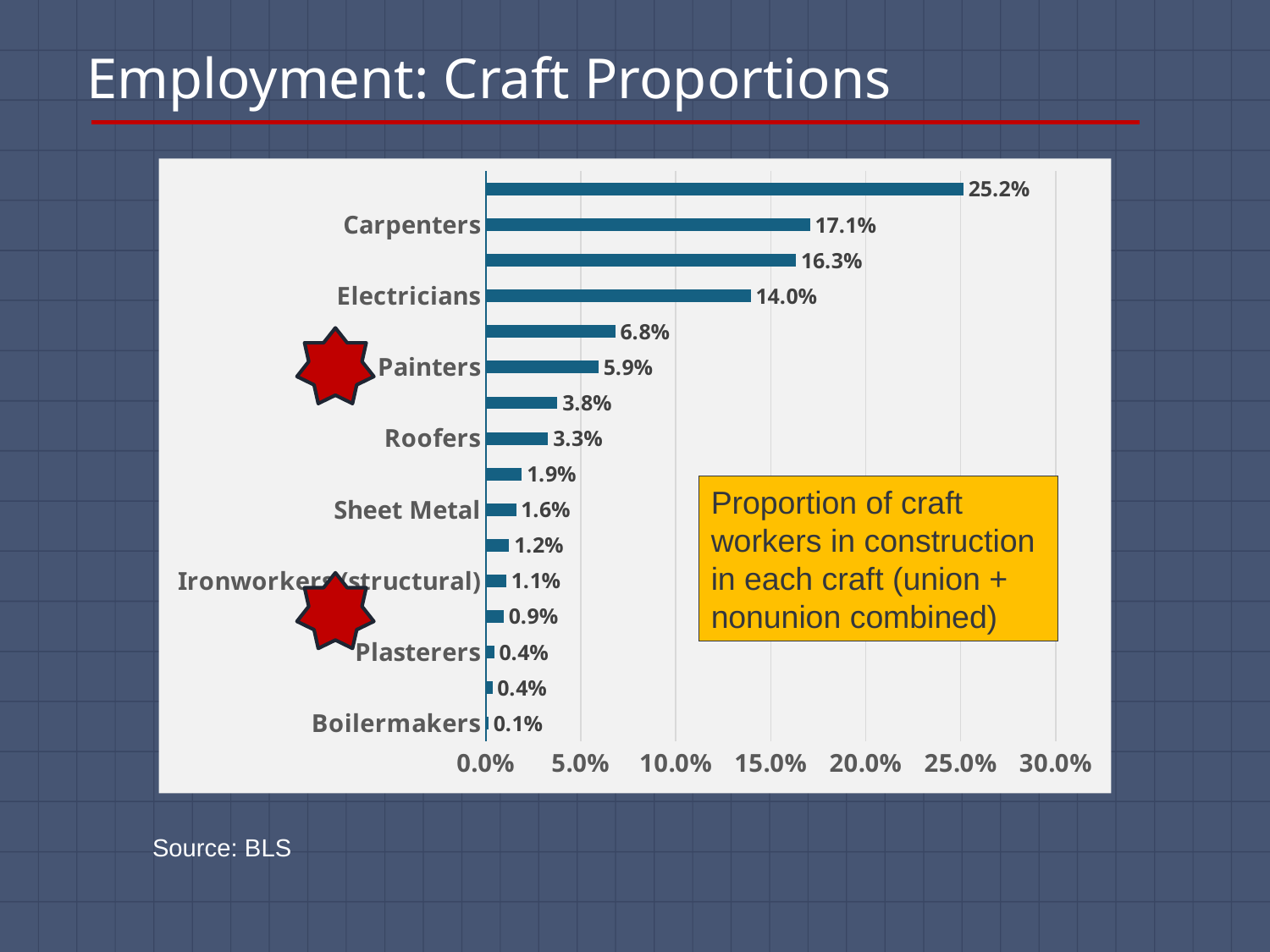
Is the value for Sheet Metal greater or less than 5.0%? less What kind of chart is shown on the slide? bar chart What is the difference between the values for Carpenters and Electricians? 3.1% What is the value for Painters? 5.9% What is the value for Ironworkers (structural)? 1.1% Which labelled craft has the lowest value? Boilermakers What is the value for Carpenters? 17.1% Which is larger, the value for Painters or the value for Roofers? Painters What is the largest value shown on the chart? 25.2% What is the title of the slide? Employment: Craft Proportions How many bars are plotted on the chart? 16 What is the value for Electricians? 14.0%